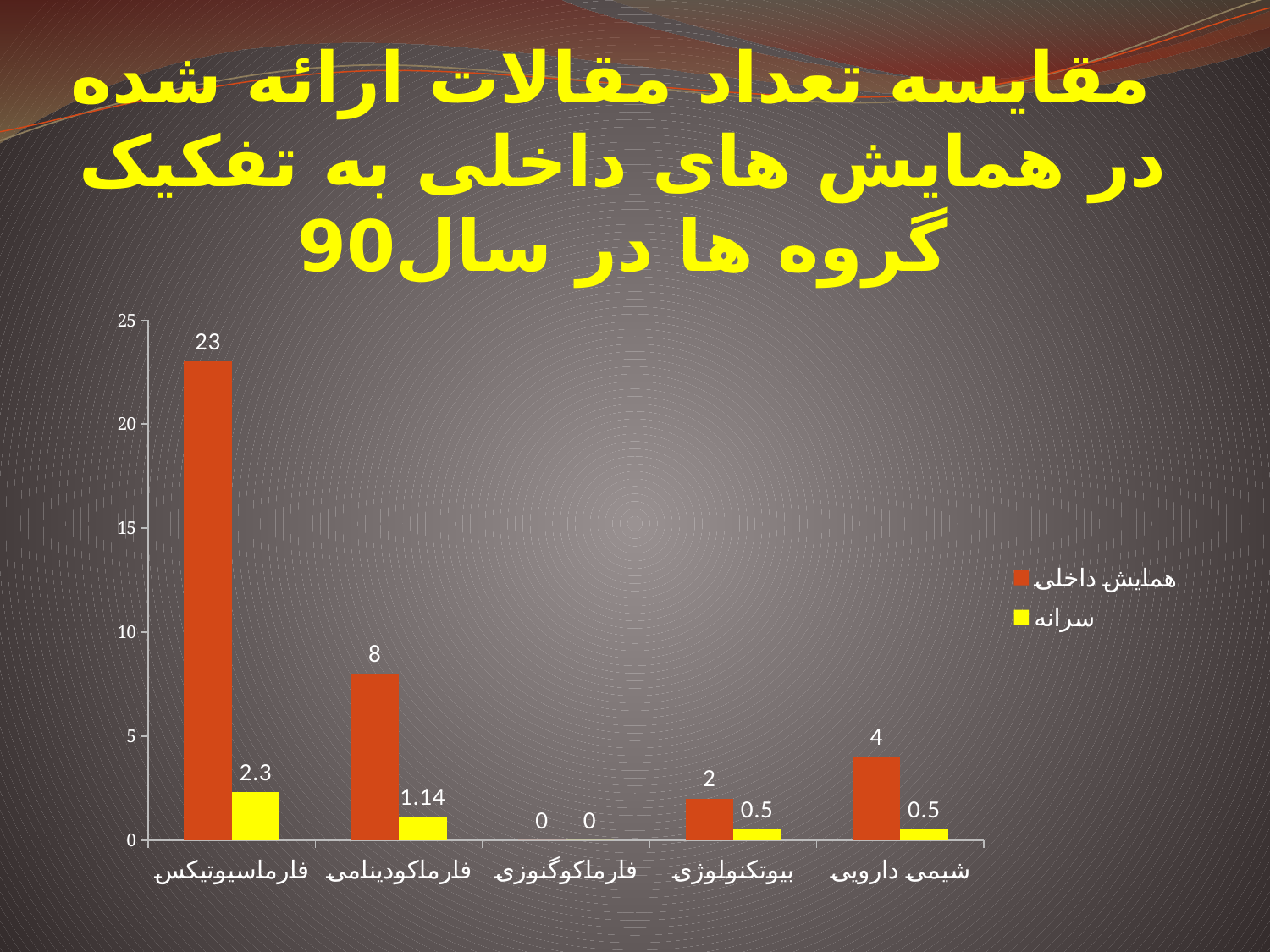
Which category has the highest value for همایش داخلی? فارماسیوتیکس How many categories are shown on the x axis? 5 How many series does the legend list? 2 What is the value of سرانه for فارماکودینامی? 1.14 What is the difference between the همایش داخلی values for فارماسیوتیکس and فارماکودینامی? 15 What is the value of همایش داخلی for فارماسیوتیکس? 23 What kind of chart is shown on the slide? bar chart What is the value of سرانه for بیوتکنولوژی? 0.5 Is the همایش داخلی value for فارماسیوتیکس greater or less than 20? greater Which category has the lowest value for همایش داخلی? فارماکوگنوزی What is the value of همایش داخلی for شیمی دارویی? 4 Which is larger: the همایش داخلی value for بیوتکنولوژی or for شیمی دارویی? شیمی دارویی